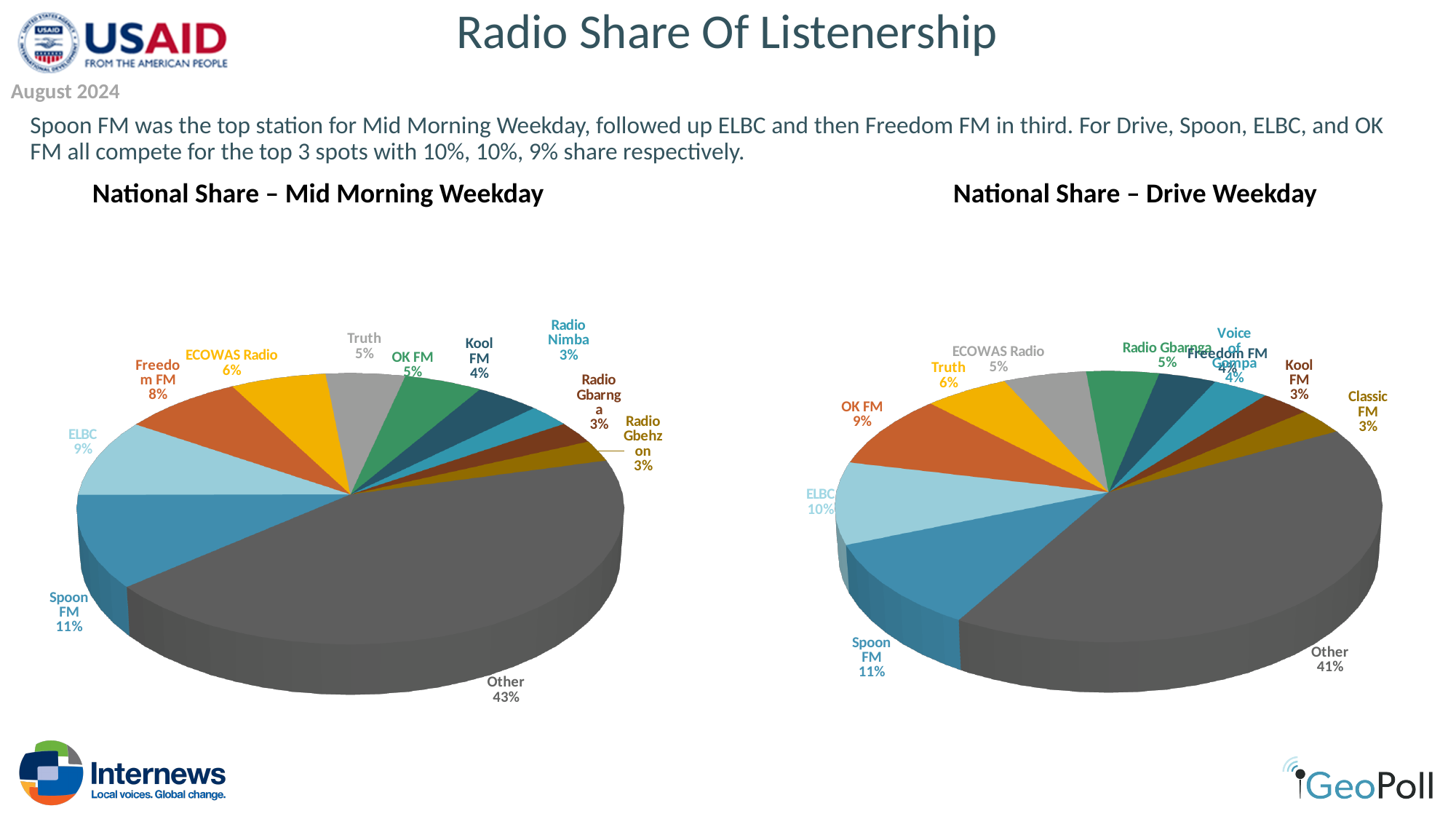
In the National Share – Mid Morning Weekday chart, what share is labelled Other? 43% In the National Share – Drive Weekday chart, what share is labelled Other? 41% In the National Share – Mid Morning Weekday chart, what share does Spoon FM have? 11% What type of chart is used for the National Share – Drive Weekday data? Pie chart How many slices does the National Share – Mid Morning Weekday pie chart have? 11 In the National Share – Drive Weekday chart, what share does ELBC have? 10% In the National Share – Mid Morning Weekday chart, what is the difference between the ELBC share and the ECOWAS Radio share? 3% In the National Share – Drive Weekday chart, which is larger, the Truth share or the Kool FM share? Truth In the National Share – Drive Weekday chart, what share does OK FM have? 9% In the National Share – Drive Weekday chart, what is the difference between the Spoon FM share and the Classic FM share? 8% In the National Share – Mid Morning Weekday chart, which named station (excluding Other) has the largest share? Spoon FM In the National Share – Mid Morning Weekday chart, what share does Freedom FM have? 8%